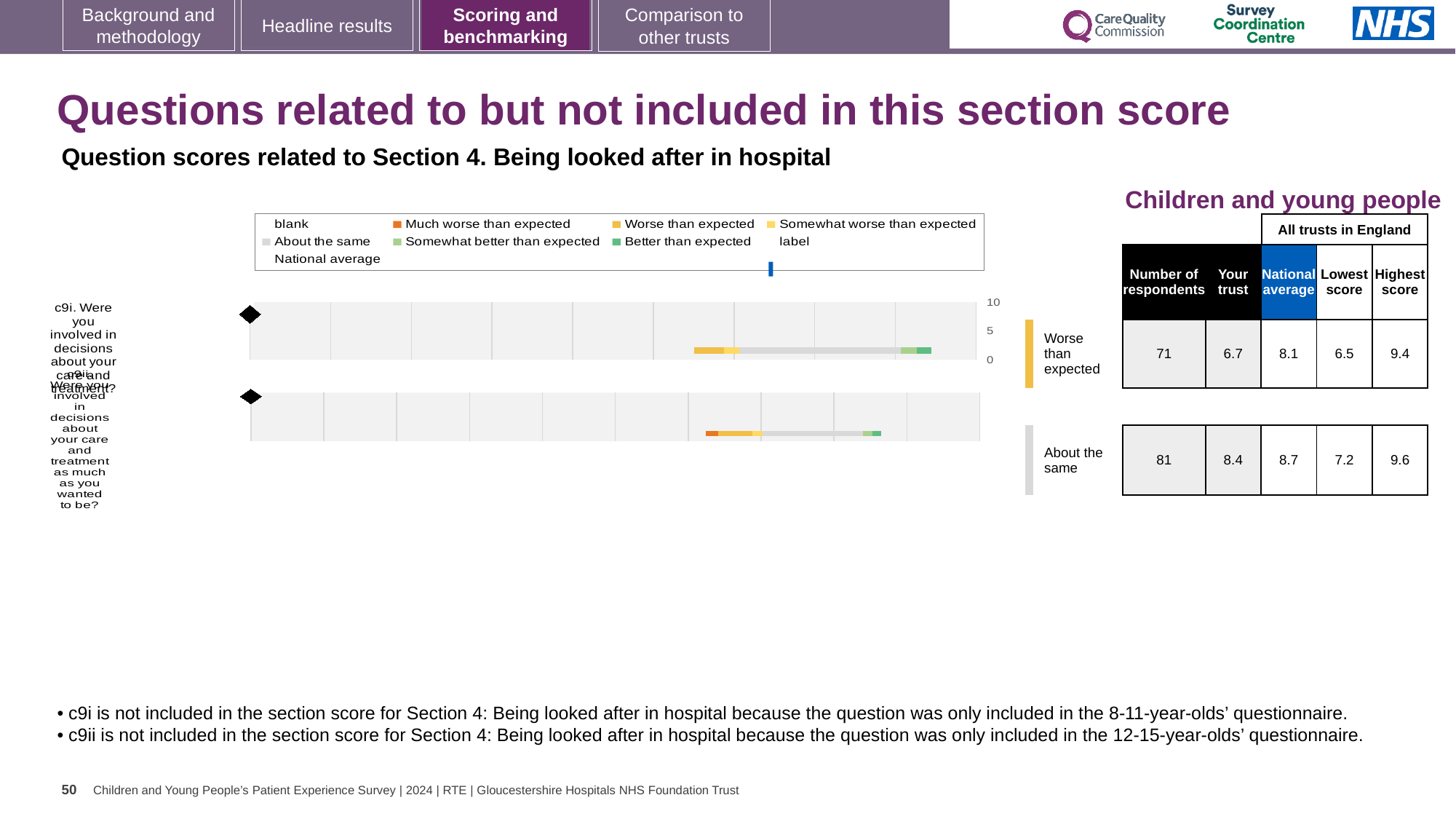
How many questions (rows) are plotted in the benchmarking chart? 2 What is the national average score for question c9ii? 8.7 Which benchmark category is question c9i placed in? Worse than expected What kind of chart is used to show the question scores for c9i and c9ii? bar chart Which question has the higher 'Your trust' score, c9i or c9ii? c9ii What is the difference between the national average and the trust's score for question c9i? 1.4 What is the highest score across all trusts in England for question c9i? 9.4 How many respondents answered question c9ii? 81 What is the 'Your trust' score for question c9i? 6.7 Which legend entry is represented by the blue marker in the chart legend? National average What is the maximum value shown on the chart's axis? 10 How many entries does the chart legend list? 9